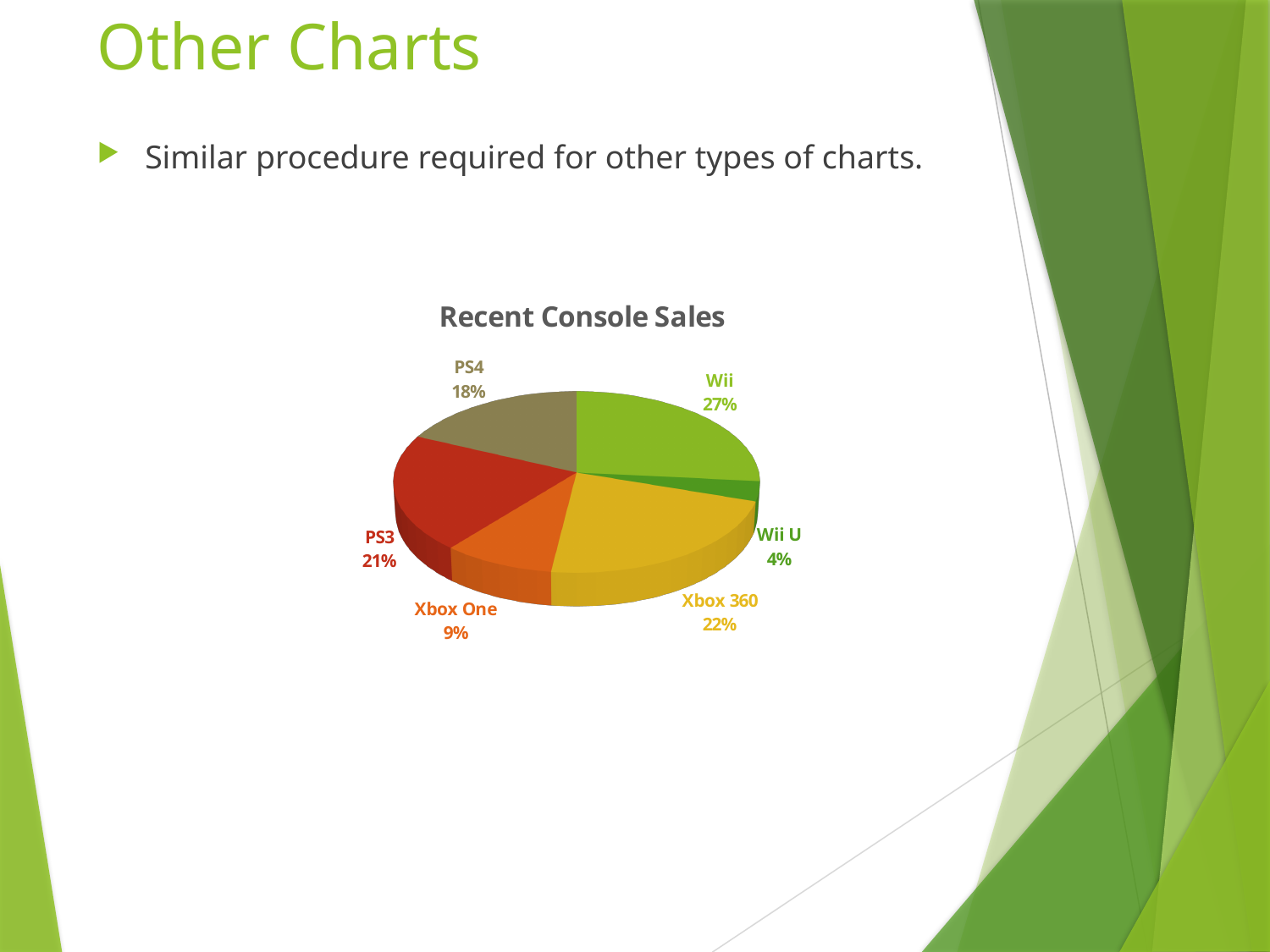
What is the title of the chart? Recent Console Sales Which console has the largest slice of the pie? Wii Which console has the smallest slice of the pie? Wii U How many slices does the pie chart have? 6 What share of the pie does Wii have? 27% What is the combined share of Xbox 360 and Xbox One? 31% What is the value shown for Xbox 360? 22% What is the difference between the PS3 and Xbox One shares? 12% What kind of chart is shown on the slide? pie chart What is the value shown for Wii U? 4% What is the value shown for PS4? 18% Which is larger, the share for PS3 or the share for PS4? PS3